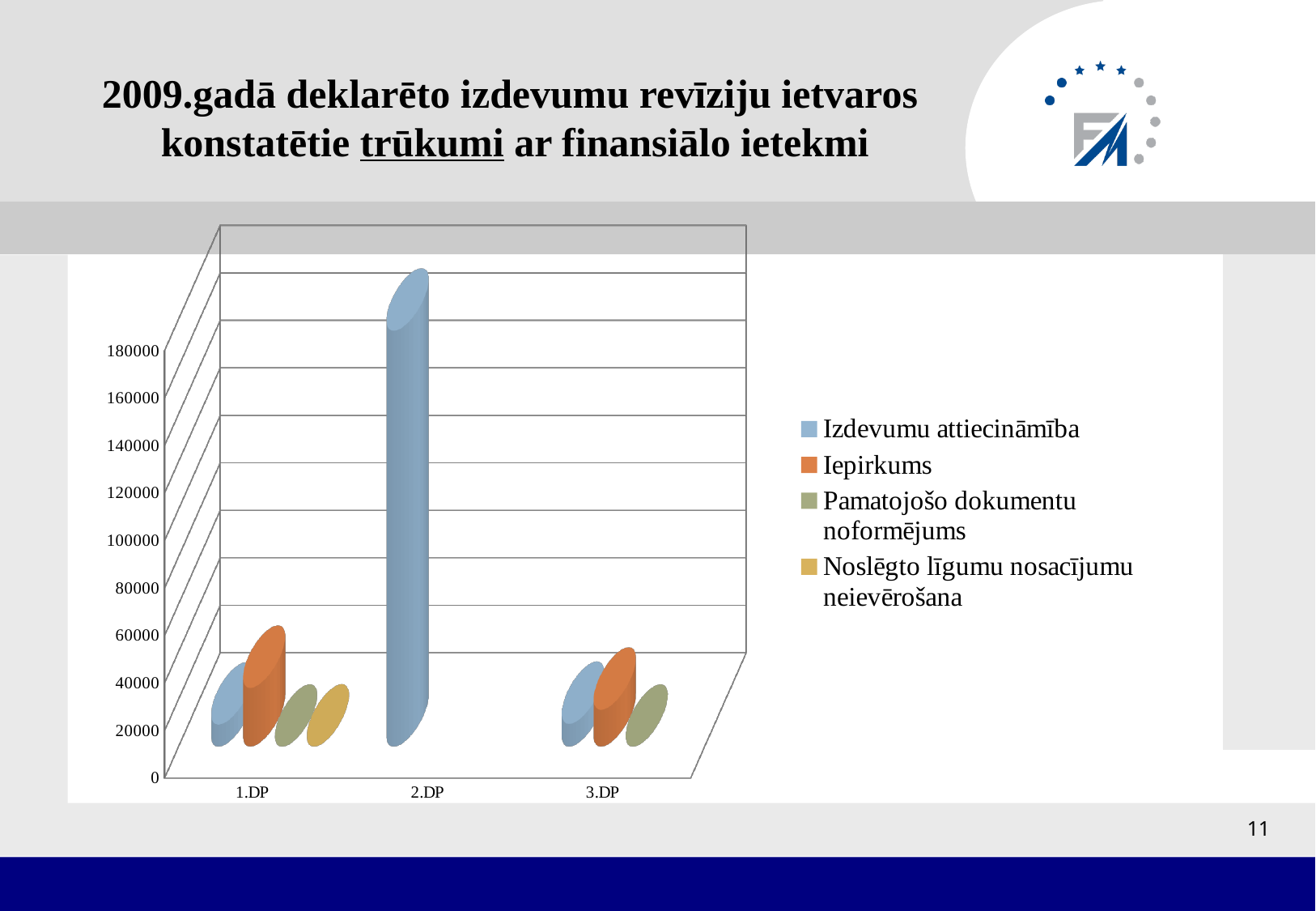
Which category has the highest value for Izdevumu attiecināmība? 2.DP How many series does the chart legend list? 4 Is the value for Iepirkums in 1.DP greater or less than 100000? less How many categories are shown on the x axis of the chart? 3 What colour represents Iepirkums in the legend? orange Which is larger in 1.DP: Iepirkums or Noslēgto līgumu nosacījumu neievērošana? Iepirkums Is the value for Izdevumu attiecināmība in 2.DP greater or less than 140000? greater Which category has no bar for Noslēgto līgumu nosacījumu neievērošana? 2.DP and 3.DP Which is larger for Izdevumu attiecināmība: 2.DP or 3.DP? 2.DP Is the value for Noslēgto līgumu nosacījumu neievērošana in 1.DP greater or less than 80000? less Which series has the tallest bar in the chart? Izdevumu attiecināmība What kind of chart is shown on the slide? bar chart